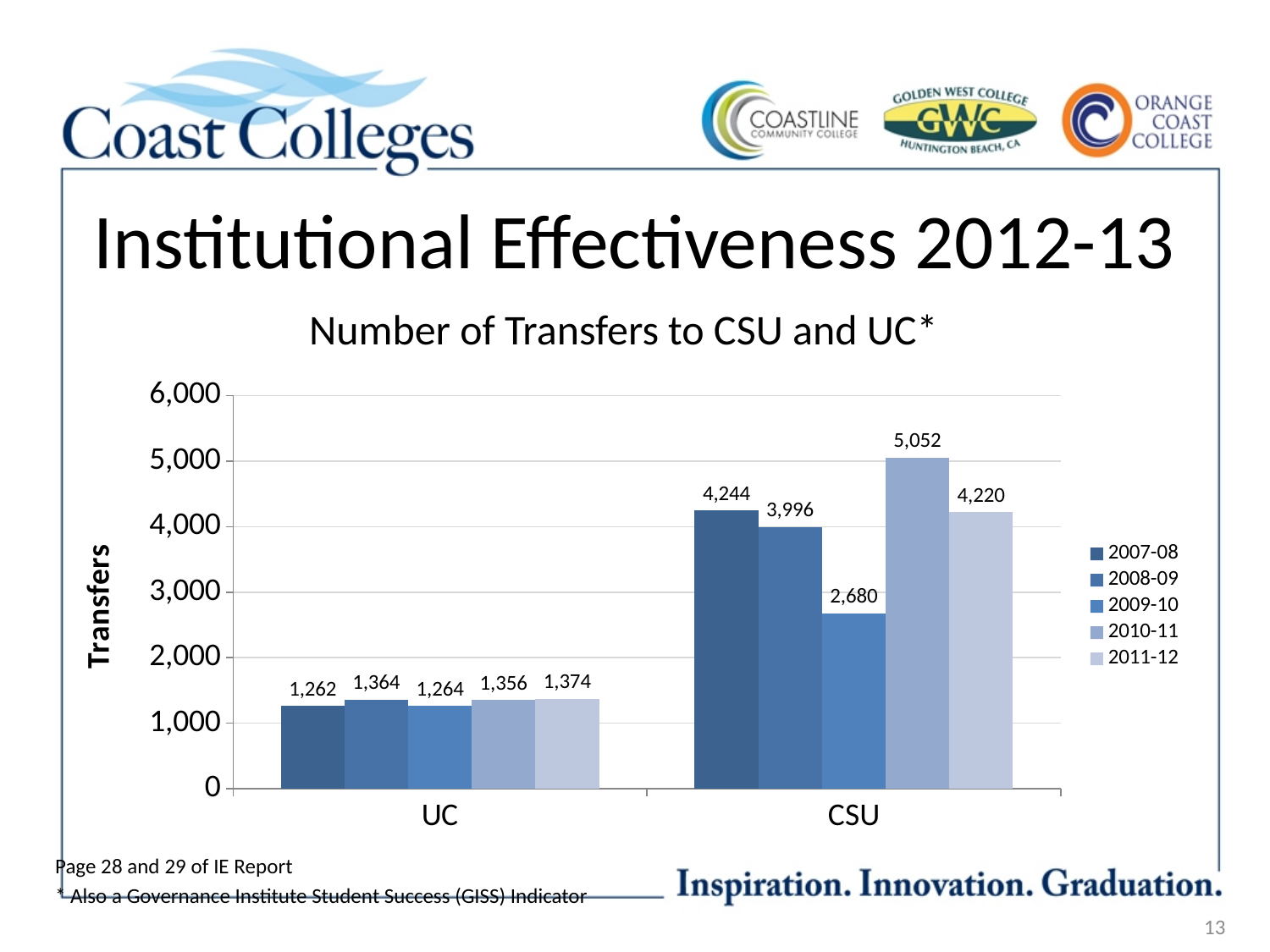
Is the number of transfers to CSU in 2007-08 greater or less than 4,000? greater What is the difference between CSU transfers in 2010-11 and 2009-10? 2,372 What is the number of transfers to CSU in 2010-11? 5,052 What is the number of transfers to UC in 2007-08? 1,262 What is the label of the vertical axis? Transfers How many categories are shown on the x axis? 2 Which year had the highest number of transfers to CSU? 2010-11 Which is larger: UC transfers in 2008-09 or UC transfers in 2009-10? 2008-09 How many series does the legend list? 5 Which year had the lowest number of transfers to CSU? 2009-10 What is the number of transfers to CSU in 2009-10? 2,680 What kind of chart is shown on the slide? Bar chart